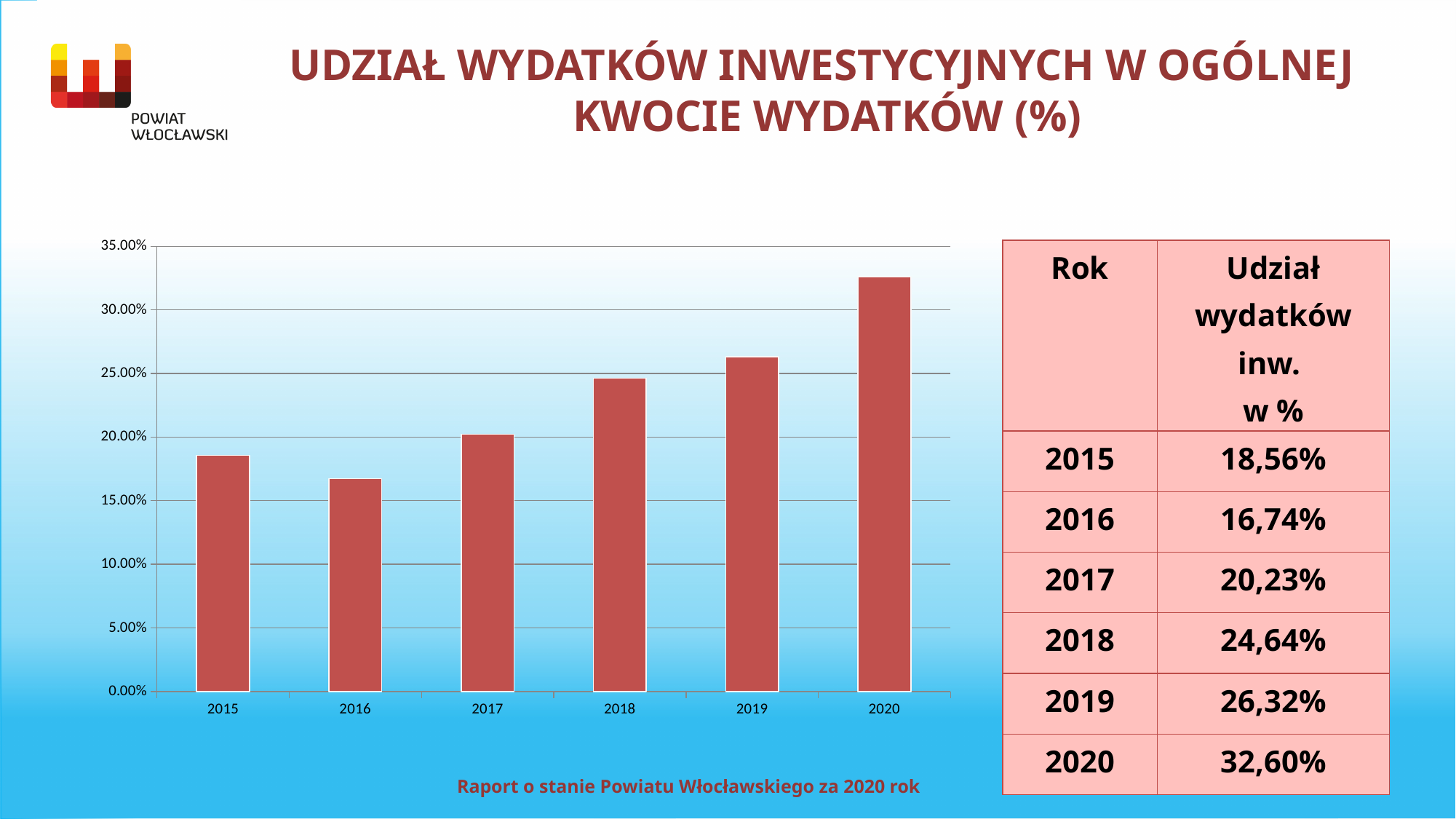
How many years are plotted on the chart? 6 What is the share of investment expenditure for 2020? 32,60% Which year has the highest share of investment expenditure? 2020 Is the value for 2016 greater or less than 20.00%? less What kind of chart is shown on the slide? bar chart What is the share of investment expenditure for 2017? 20,23% What is the difference between the values for 2020 and 2015? 14,04 percentage points What is the title of the chart on the slide? UDZIAŁ WYDATKÓW INWESTYCYJNYCH W OGÓLNEJ KWOCIE WYDATKÓW (%) Which is larger, the value for 2015 or the value for 2016? 2015 Do the values generally rise or fall from 2016 to 2020? rise Which year has the lowest share of investment expenditure? 2016 Is the value for 2019 greater or less than 25.00%? greater